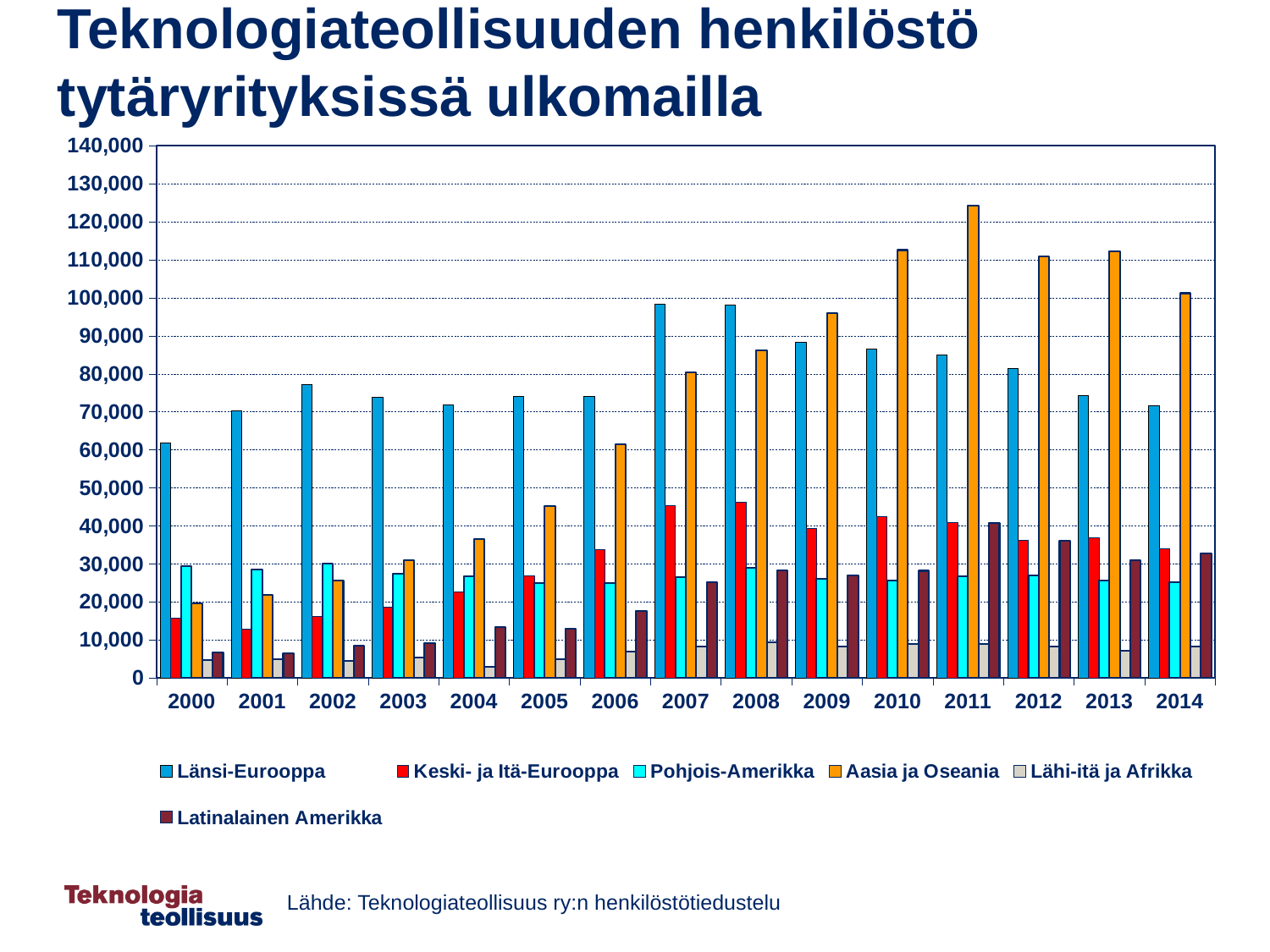
Which series has the lowest values in every year? Lähi-itä ja Afrikka Is the value for Länsi-Eurooppa in 2000 greater or less than 70,000? less Is the value for Keski- ja Itä-Eurooppa in 2008 greater or less than 40,000? greater How many series does the legend list? 6 Do the values for Aasia ja Oseania rise or fall from 2000 to 2011? rise In 2000, which is larger: Länsi-Eurooppa or Aasia ja Oseania? Länsi-Eurooppa Is the value for Aasia ja Oseania in 2011 greater or less than 120,000? greater What kind of chart is shown on the slide? bar chart How many years are shown on the x axis? 15 In 2014, which is larger: Aasia ja Oseania or Länsi-Eurooppa? Aasia ja Oseania In which year is the value for Aasia ja Oseania highest? 2011